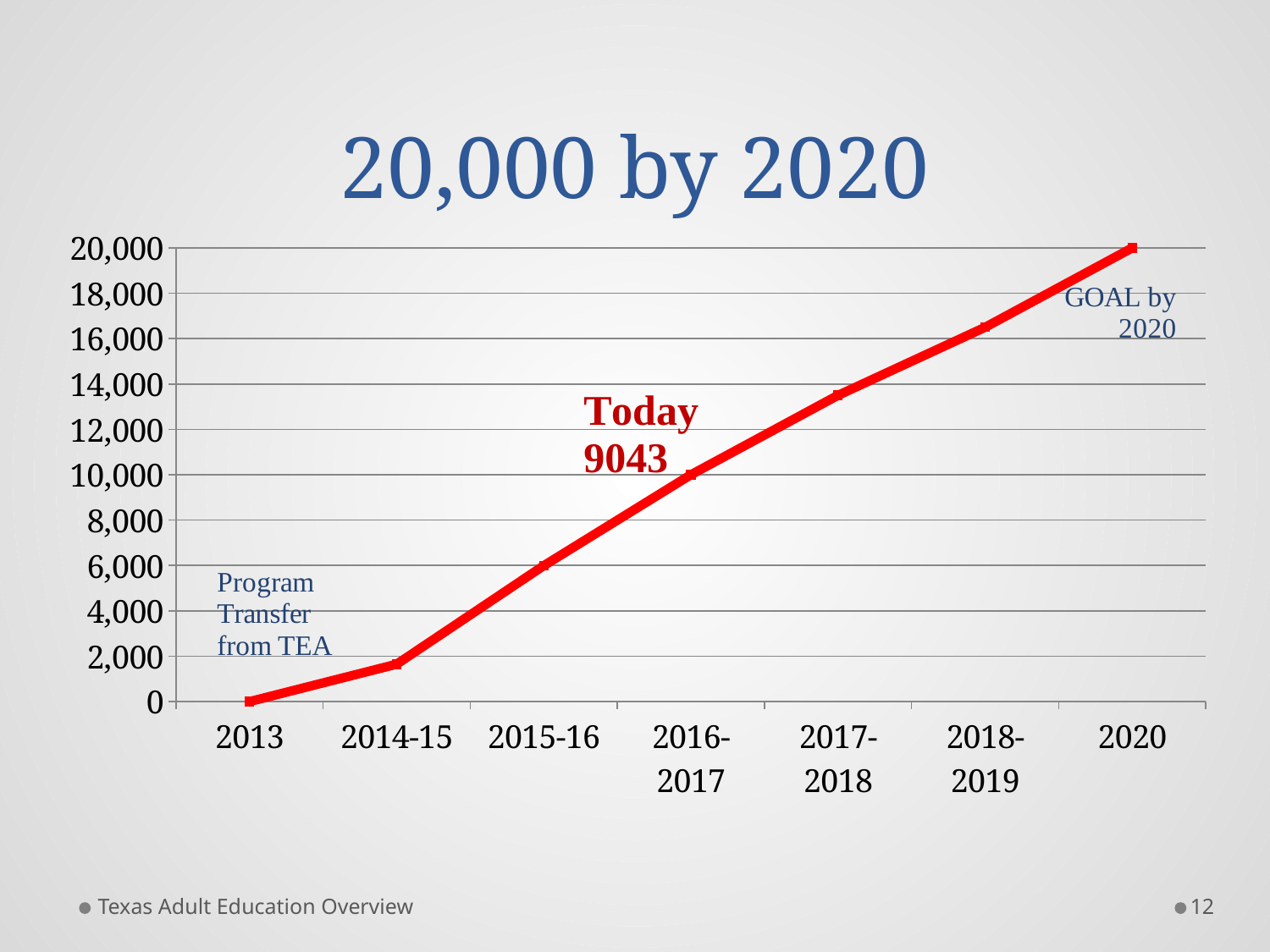
What is the value for 2013? 0 Is the value for 2017-2018 greater or less than 12,000? greater Is the value for 2014-15 greater or less than 2,000? less What number is shown in the 'Today' annotation on the chart? 9043 Which is larger, the value for 2017-2018 or the value for 2015-16? 2017-2018 What kind of chart is shown on the slide? line chart Which category has the lowest value? 2013 Do the values rise or fall from 2013 to 2020? rise Which category has the highest value? 2020 What is the title of the chart? 20,000 by 2020 How many data points are plotted along the x axis? 7 What is the value for 2020? 20,000